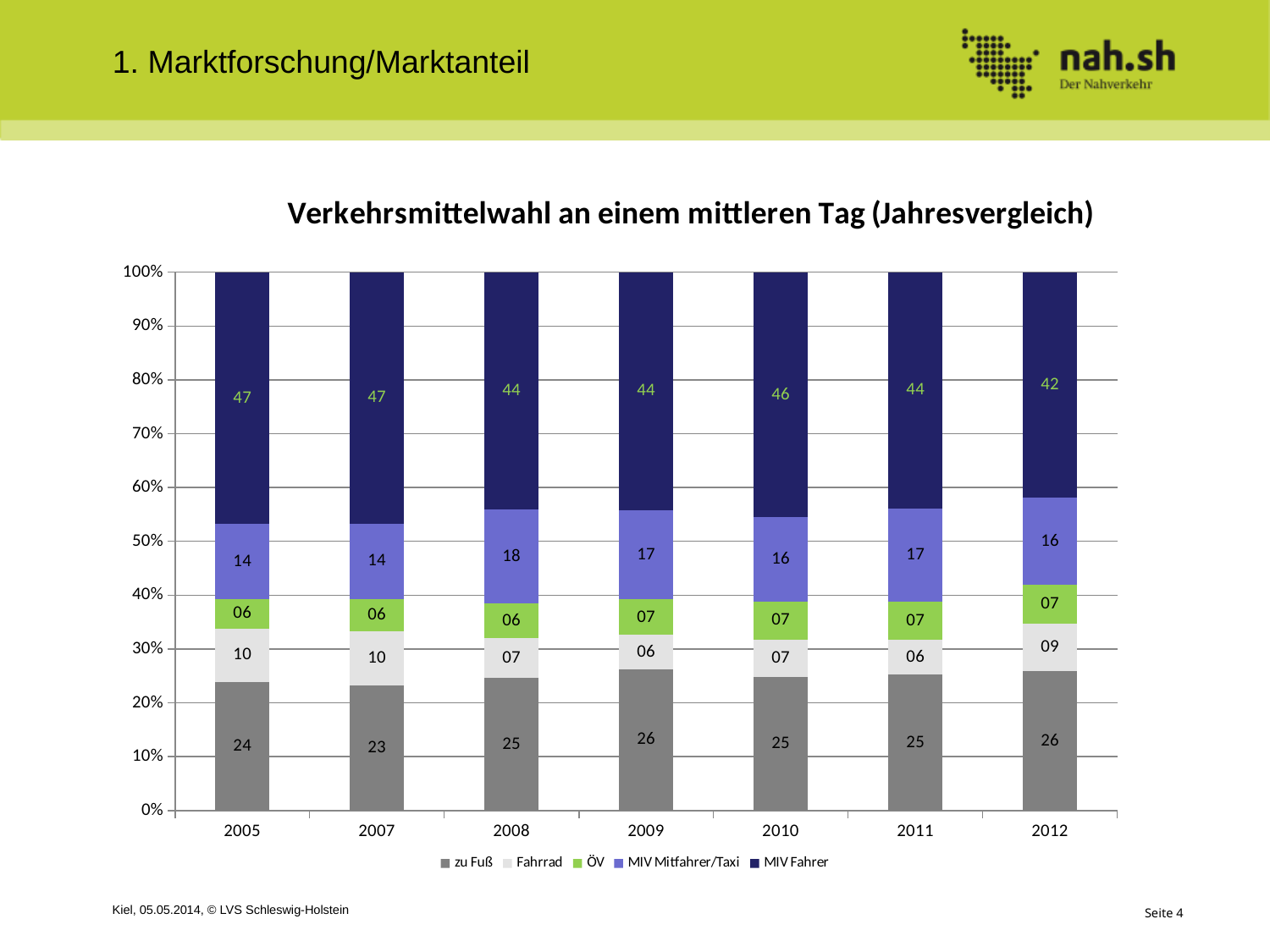
What is the value for MIV Mitfahrer/Taxi in 2008? 18 What is the value for MIV Fahrer in 2005? 47 How many years are shown on the x axis? 7 What is the difference between the MIV Fahrer values in 2005 and 2012? 5 How many series does the legend list? 5 Which is larger, the Fahrrad value in 2005 or the Fahrrad value in 2009? 2005 What is the title of the chart? Verkehrsmittelwahl an einem mittleren Tag (Jahresvergleich) In which year is the MIV Mitfahrer/Taxi value highest? 2008 What kind of chart is shown on the slide? Stacked bar chart In which year is the MIV Fahrer value lowest? 2012 What is the value for zu Fuß in 2007? 23 What is the value for Fahrrad in 2012? 09